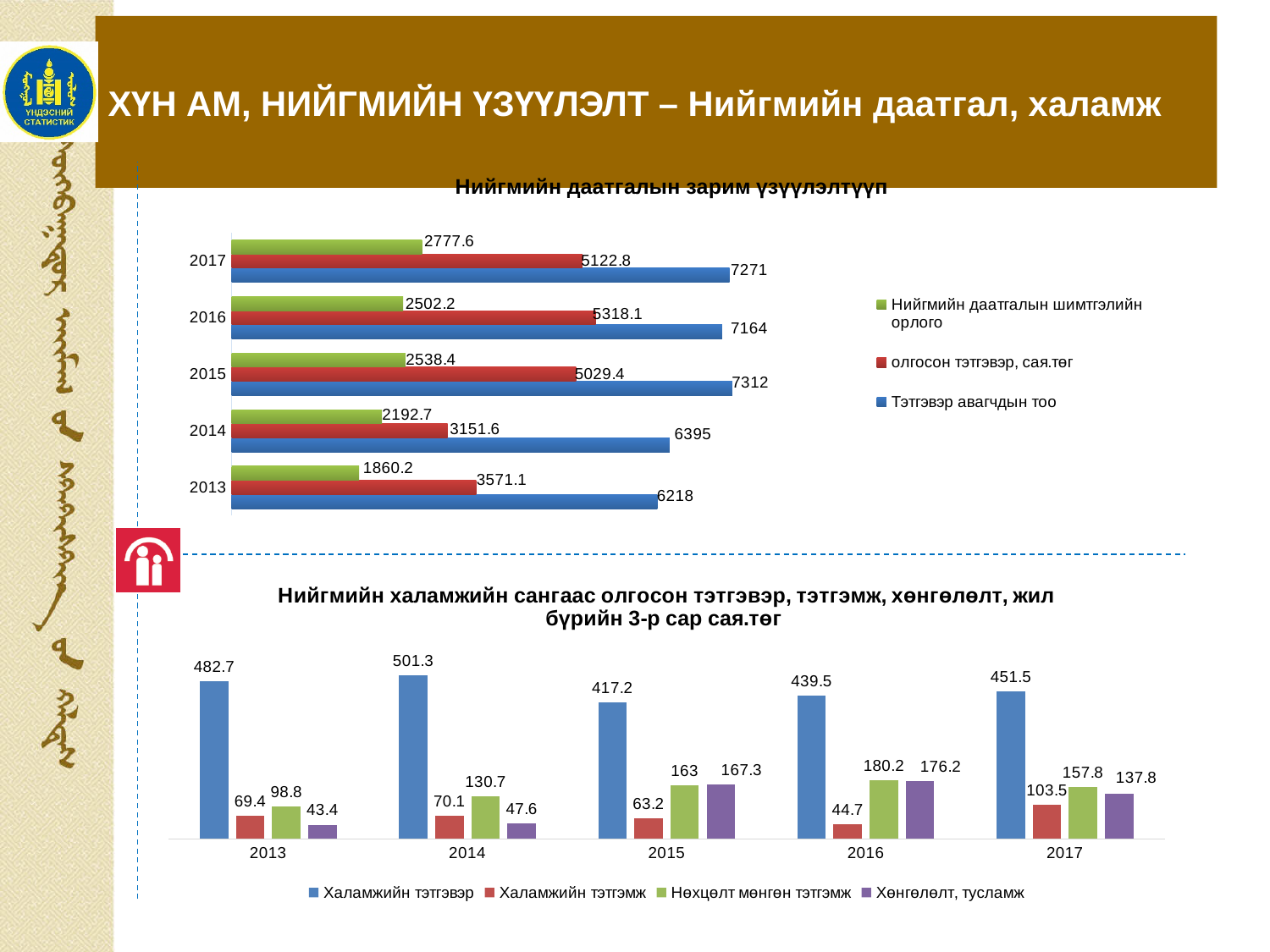
In the top chart, which year has the highest value for Тэтгэвэр авагчдын тоо? 2015 In the top chart, what is the value of олгосон тэтгэвэр, сая.төг for 2014? 3151.6 In the top chart, what is the difference between the Тэтгэвэр авагчдын тоо values for 2017 and 2013? 1053 How many series does the legend of the bottom chart list? 4 In the bottom chart, which is larger for 2015: Нөхцөлт мөнгөн тэтгэмж or Хөнгөлөлт, тусламж? Хөнгөлөлт, тусламж In the bottom chart, what is the difference between Халамжийн тэтгэвэр in 2014 and in 2015? 84.1 How many series does the legend of the top chart list? 3 In the bottom chart, which year has the lowest value for Халамжийн тэтгэмж? 2016 What kind of chart is the top chart? Bar chart In the top chart (Нийгмийн даатгалын зарим үзүүлэлтүүп), what is the value of Тэтгэвэр авагчдын тоо for 2017? 7271 In the top chart, which year has the lowest value for Нийгмийн даатгалын шимтгэлийн орлого? 2013 In the bottom chart (Нийгмийн халамжийн сангаас олгосон тэтгэвэр, тэтгэмж, хөнгөлөлт), what is the value of Халамжийн тэтгэвэр for 2014? 501.3